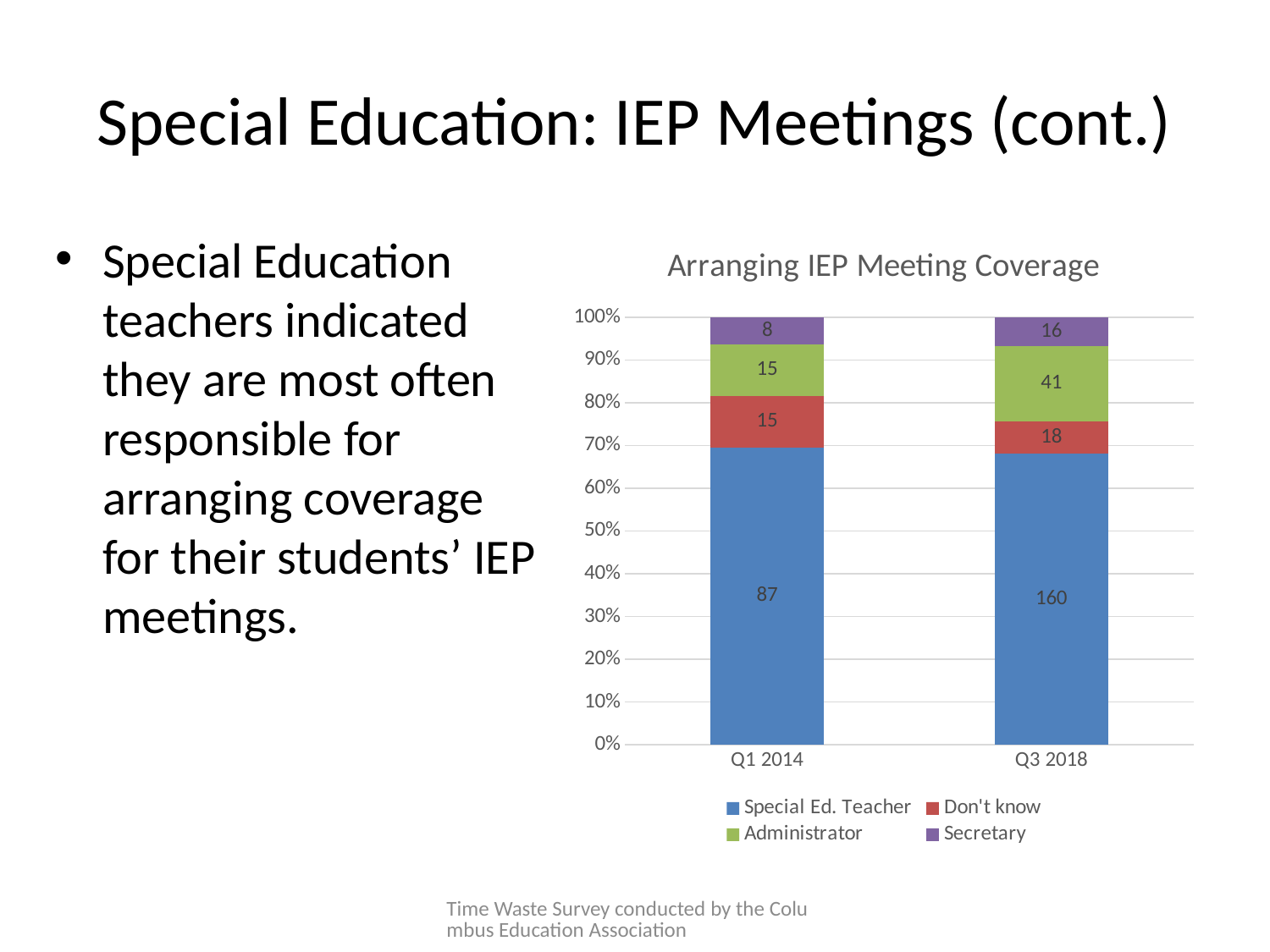
Which series has the smallest value in the Q1 2014 bar? Secretary What is the data label for Don't know in Q3 2018? 18 What is the total of the data labels in the Q1 2014 bar? 125 Which series has the largest value in the Q3 2018 bar? Special Ed. Teacher What is the data label for Special Ed. Teacher in Q1 2014? 87 Which is larger, the Administrator value in Q1 2014 or in Q3 2018? Q3 2018 What is the data label for Secretary in Q1 2014? 8 What is the data label for Administrator in Q3 2018? 41 How many categories are shown on the x axis? 2 What kind of chart is shown on the slide? Stacked bar chart How many series does the legend list? 4 What is the difference between the Special Ed. Teacher values for Q3 2018 and Q1 2014? 73